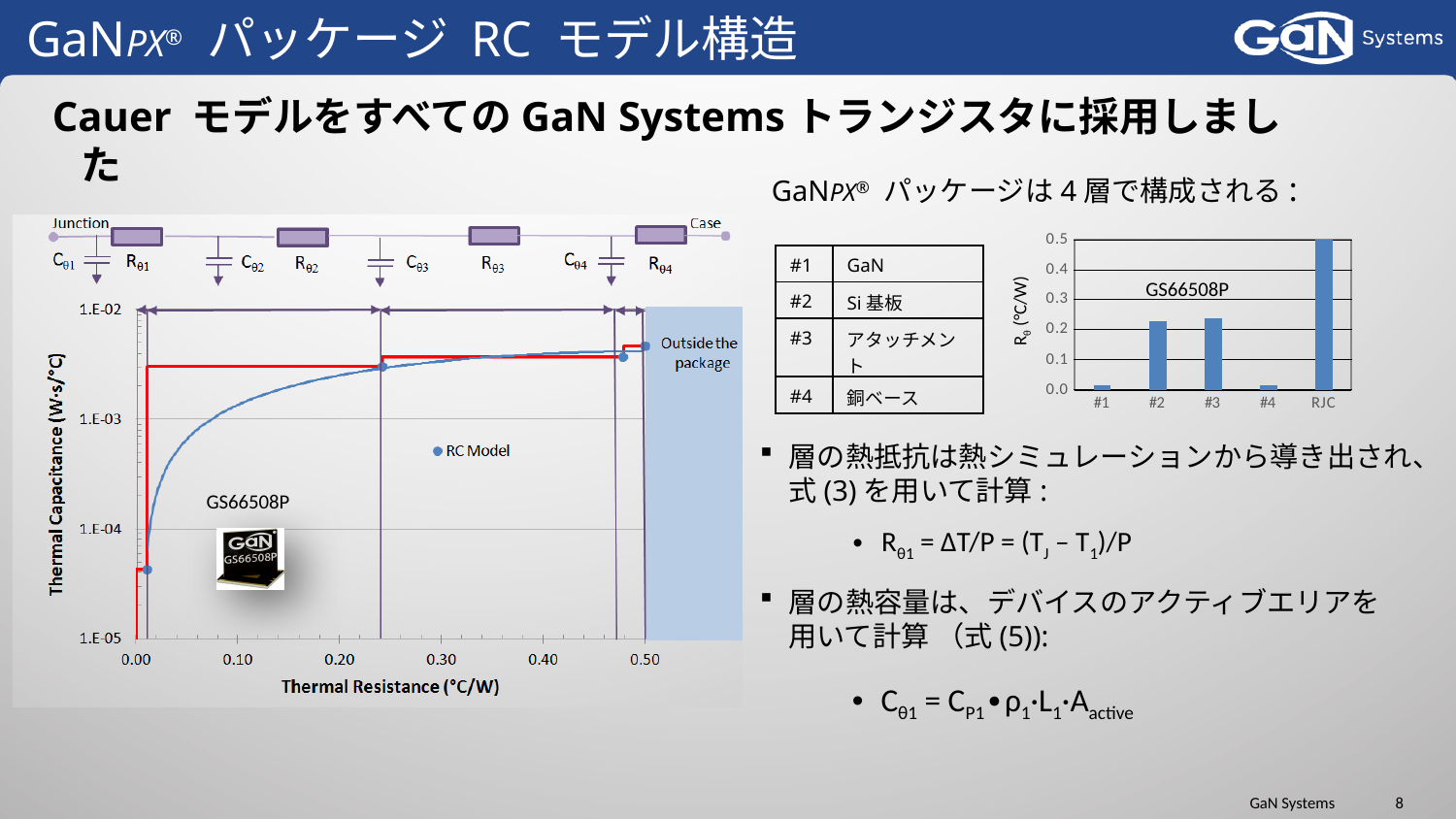
In the bar chart on the right, is the value for RJC greater or less than 0.4? greater In the bar chart on the right, is the value for #1 greater or less than 0.1? less In the bar chart on the right, which is larger, the value for #2 or the value for #4? #2 In the bar chart on the right, which category has the highest value? RJC In the bar chart on the right, is the value for #4 greater or less than 0.1? less In the chart on the left, how many series does the legend list? 1 In the chart on the left, what is the x axis label? Thermal Resistance (°C/W) What kind of chart is the chart on the right of the slide? bar chart In the bar chart on the right, how many categories are shown on the x axis? 5 In the bar chart on the right, what is the y axis label? Rθ (°C/W)